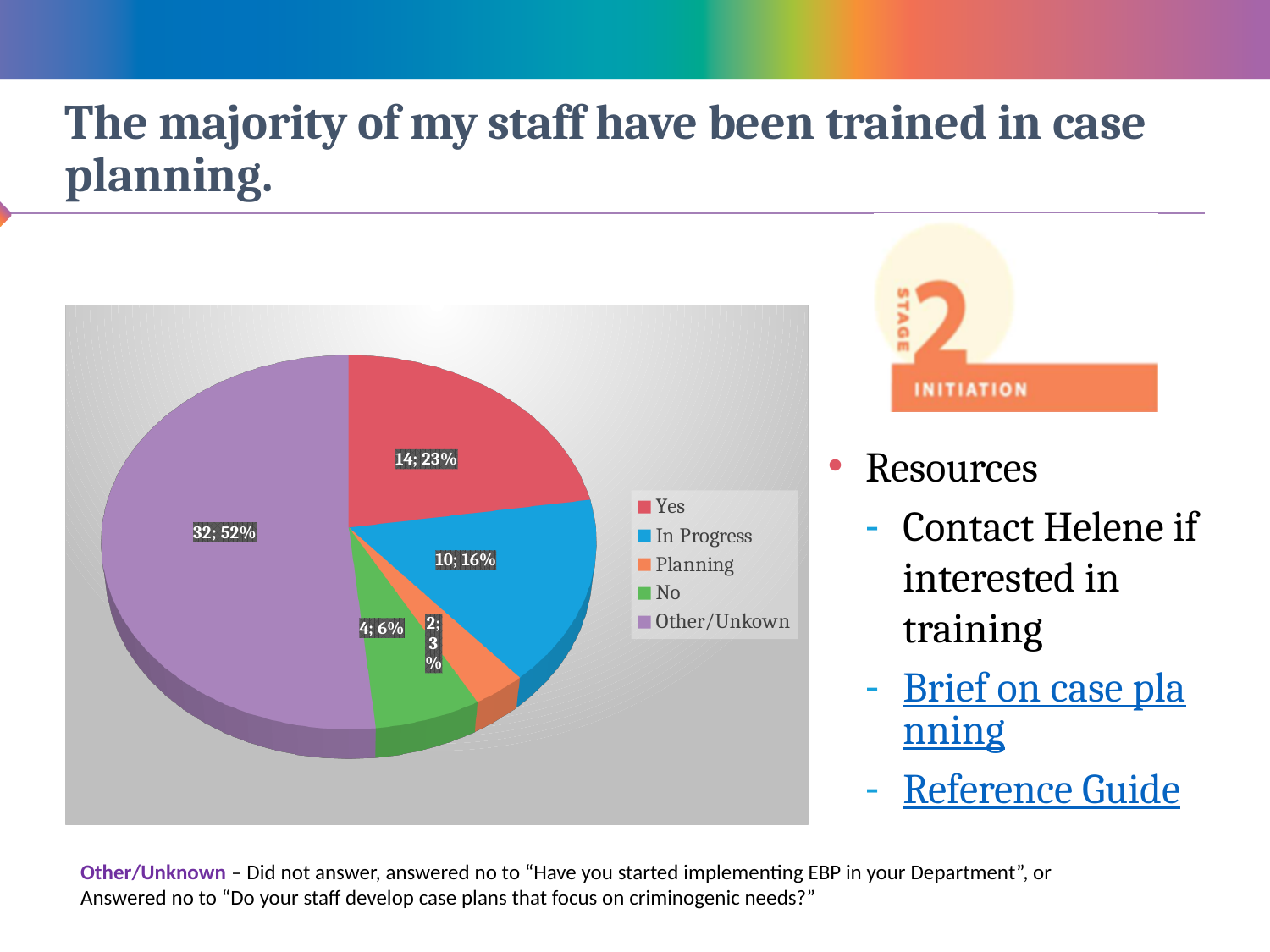
What is the count for the No slice? 4 Which is larger, the Yes slice or the In Progress slice? Yes What is the difference in count between Other/Unkown and Yes? 18 Which category has the largest slice? Other/Unkown How many categories does the pie chart show? 5 What kind of chart is shown on the slide? pie chart How many entries does the legend list? 5 What colour is the Other/Unkown slice? purple Which category has the smallest slice? Planning What is the count for the Yes slice? 14 What percentage of the pie is the Planning slice? 3% What percentage of the pie is the In Progress slice? 16%